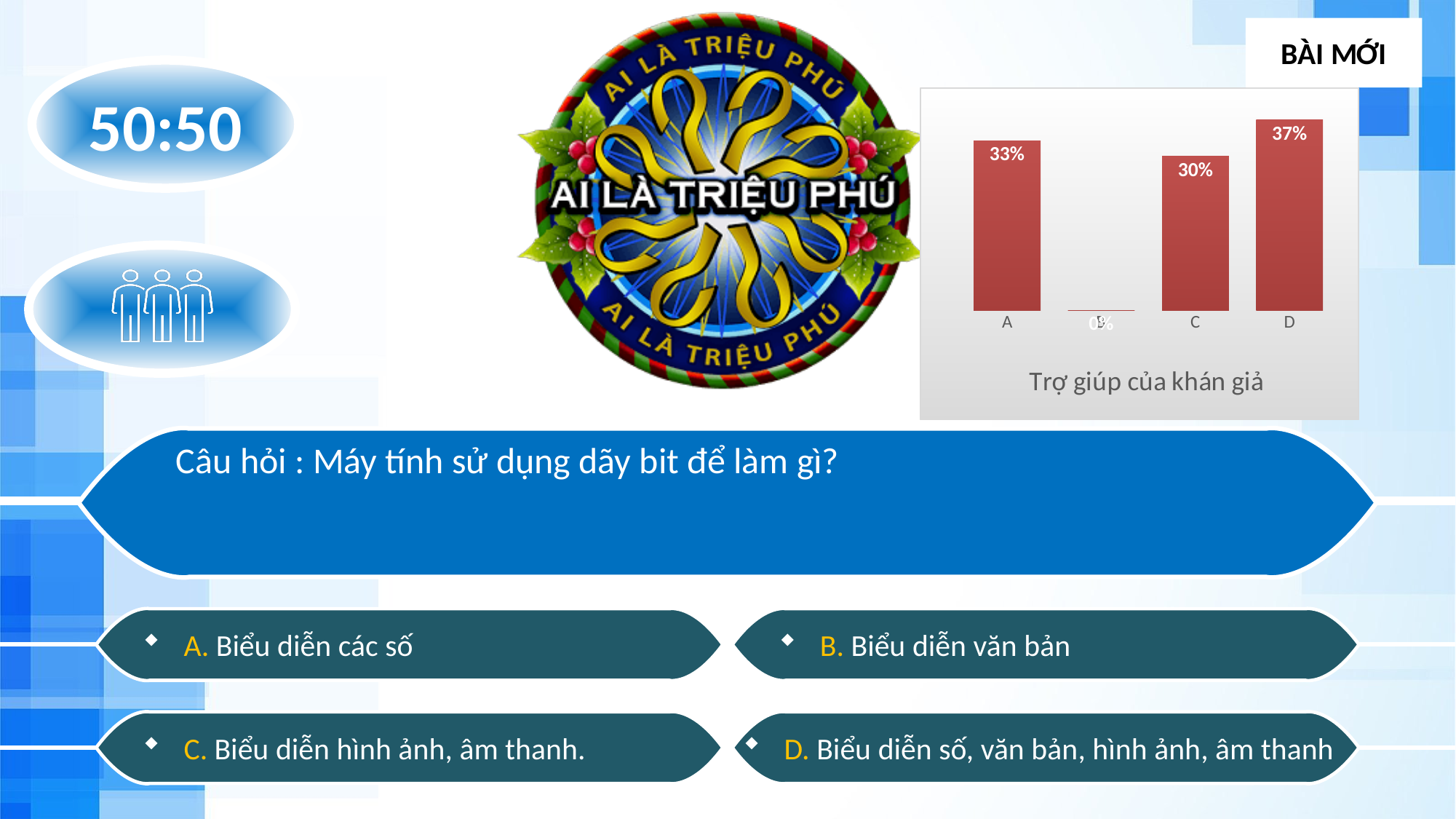
What is the value for category A in the chart? 33% Which category has the highest value in the chart? D Which category has the lowest value in the chart? B What is the value for category D in the chart? 37% What is the difference between the values for A and C? 3% What kind of chart is shown on the slide? Bar chart What is the value for category C in the chart? 30% How many categories are shown in the chart? 4 Which is larger, the value for A or the value for C? A What is the title of the chart? Trợ giúp của khán giả What is the difference between the values for D and A? 4% What is the value for category B in the chart? 0%